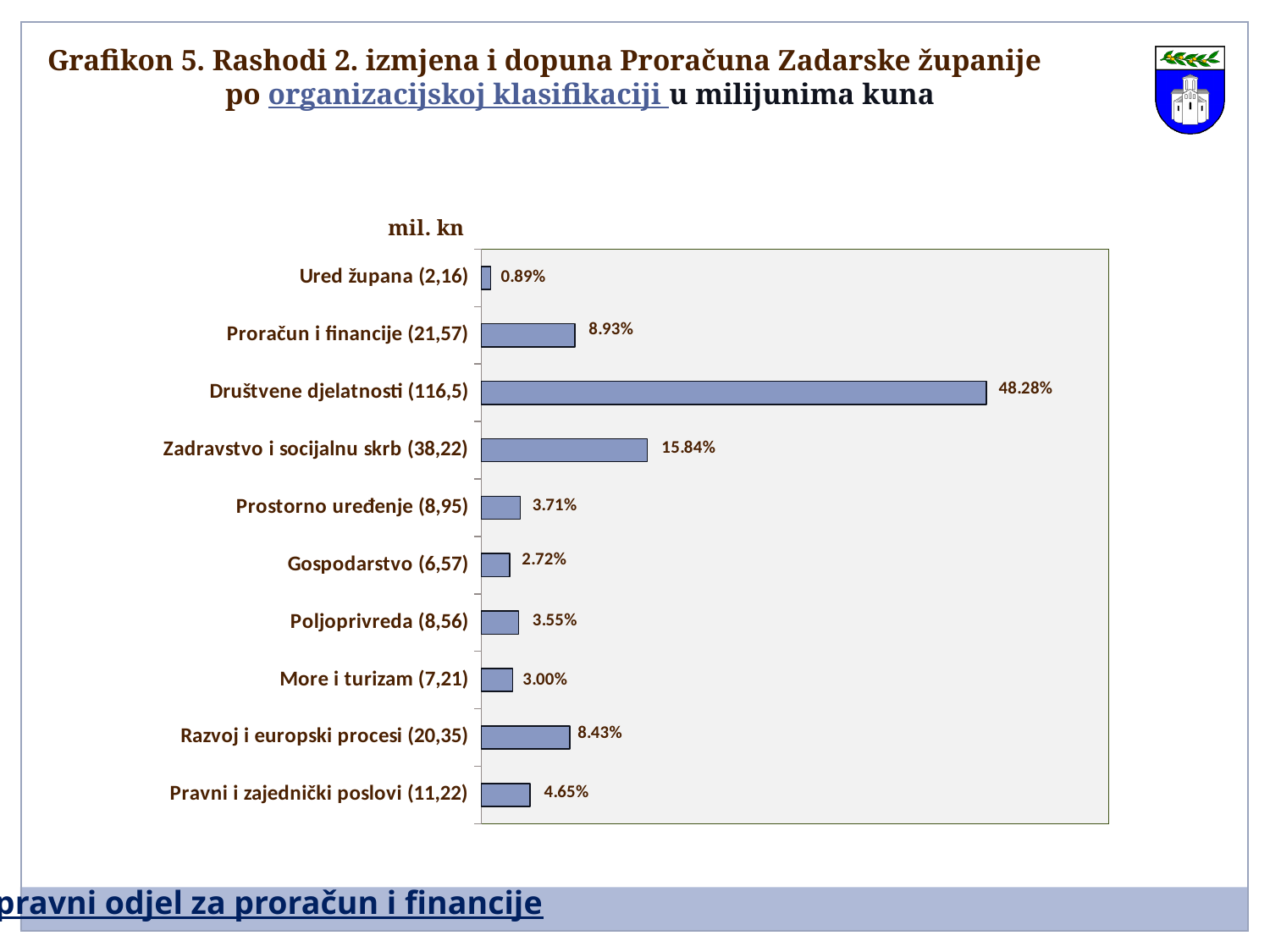
Which has a larger percentage, Poljoprivreda or Gospodarstvo? Poljoprivreda What percentage is shown for Društvene djelatnosti? 48.28% What kind of chart is shown on the slide? Bar chart What percentage is shown for Ured župana? 0.89% Which category has the lowest percentage? Ured župana What value in mil. kn is shown in the label for Pravni i zajednički poslovi? 11,22 How many categories are shown in the chart? 10 What percentage is shown for Zadravstvo i socijalnu skrb? 15.84% What unit label appears above the category axis of the chart? mil. kn What is the difference in percentage points between Proračun i financije and Razvoj i europski procesi? 0.50% What percentage is shown for Razvoj i europski procesi? 8.43% Which category has the highest percentage? Društvene djelatnosti